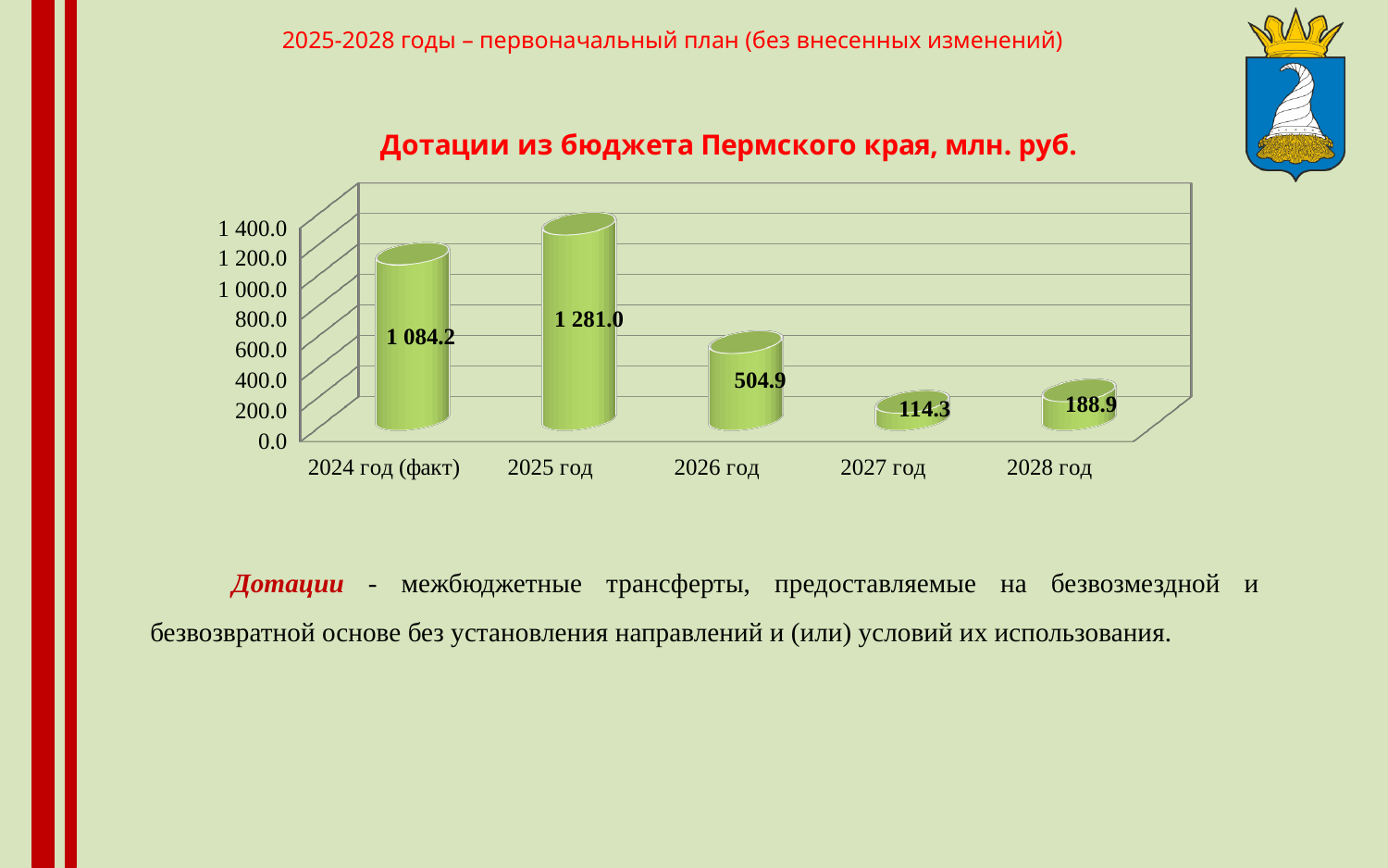
Which is larger, the value for 2026 год or the value for 2028 год? 2026 год What is the title of the chart? Дотации из бюджета Пермского края, млн. руб. Which year has the lowest value? 2027 год What is the value for 2027 год? 114.3 What is the value for 2025 год? 1 281.0 What kind of chart is this? Bar chart What is the difference between the values for 2025 год and 2024 год (факт)? 196.8 What is the value for 2028 год? 188.9 How many years are shown on the chart? 5 What is the value for 2024 год (факт)? 1 084.2 What is the difference between the values for 2028 год and 2027 год? 74.6 Which year has the highest value? 2025 год